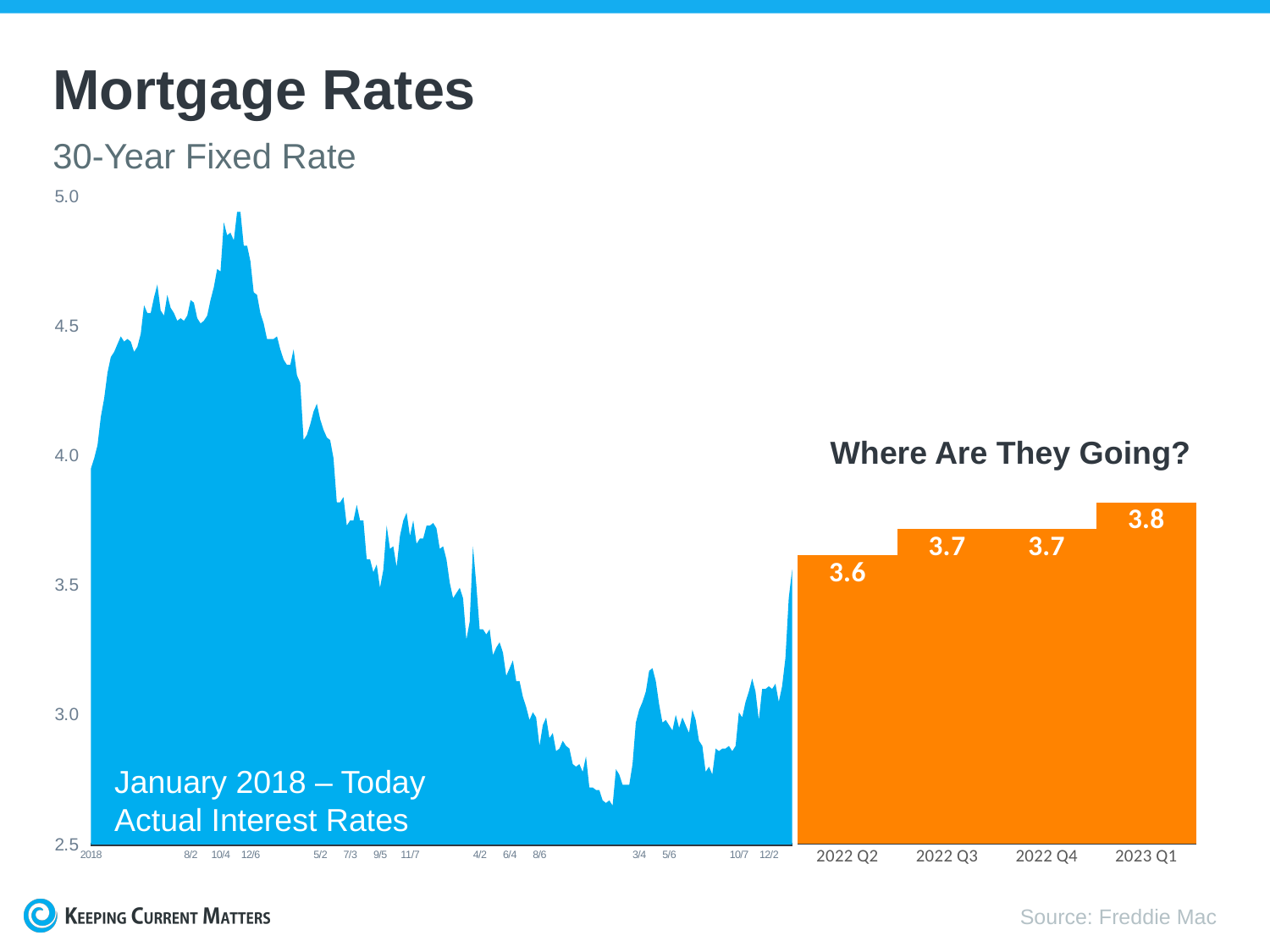
What kind of chart shows the projected rates under 'Where Are They Going?' bar chart Is the peak of the actual interest rates in late 2018 greater or less than 4.5? greater Which is larger, the projected rate for 2023 Q1 or the projected rate for 2022 Q2? 2023 Q1 Do the projected rates rise or fall from 2022 Q2 to 2023 Q1? rise How many projected quarters are shown in the orange bars? 4 Which projected quarter has the highest rate? 2023 Q1 What is the projected 30-year fixed rate for 2023 Q1? 3.8 Which projected quarter has the lowest rate? 2022 Q2 What is the difference between the projected rate for 2023 Q1 and the projected rate for 2022 Q2? 0.2 What is the projected 30-year fixed rate for 2022 Q2? 3.6 Is the lowest point of the actual interest rates greater or less than 3.0? less What is the projected 30-year fixed rate for 2022 Q4? 3.7